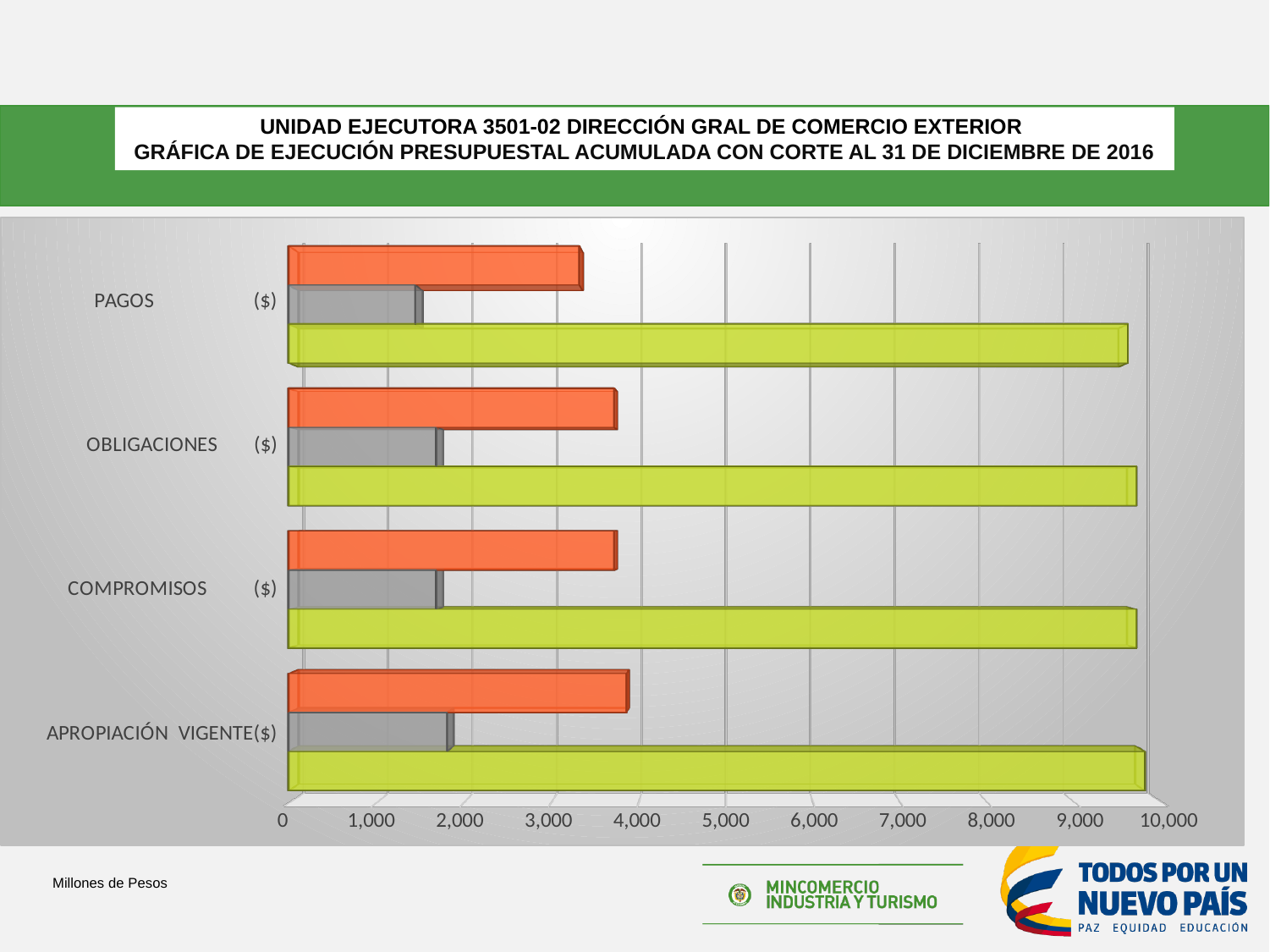
Is the value of the orange bar for PAGOS greater or less than 3,000? greater Is the value of the gray bar for PAGOS greater or less than 2,000? less Is the value of the green bar for PAGOS greater or less than 9,000? greater Among the orange bars, which category has the lowest value? PAGOS How many bars are plotted for each category in the chart? 3 What kind of chart is shown on the slide? bar chart What unit is stated for the values in the chart, according to the note at the bottom left of the slide? Millones de Pesos Which is larger, the orange bar for PAGOS or the orange bar for APROPIACIÓN VIGENTE? APROPIACIÓN VIGENTE Among the gray bars, which category has the lowest value? PAGOS How many categories are shown on the vertical axis of the chart? 4